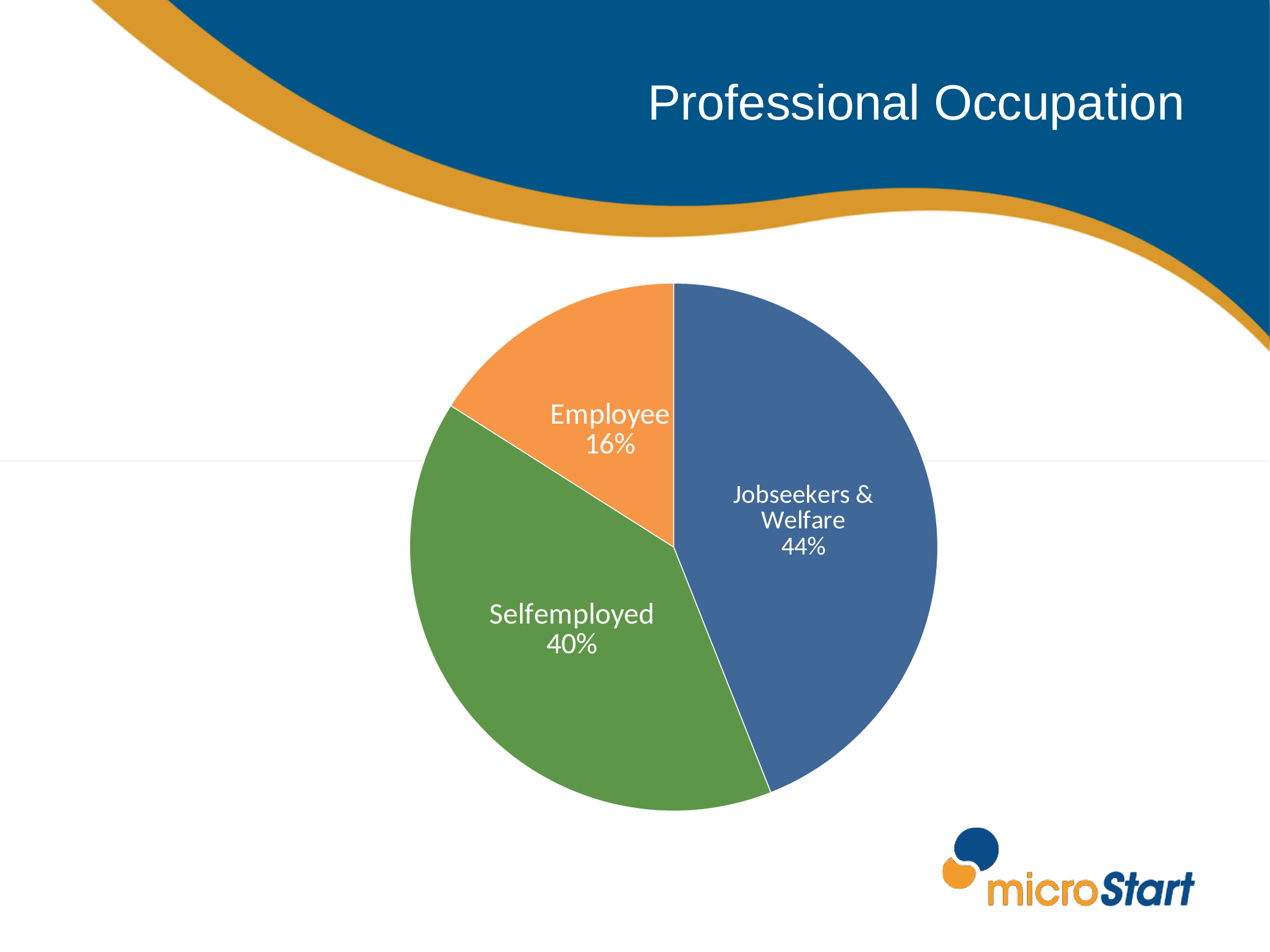
What share of the pie does Jobseekers & Welfare represent? 44% What is the title of the slide containing the chart? Professional Occupation What kind of chart is shown on the slide? Pie chart What colour is the Selfemployed slice? Green What share of the pie does Employee represent? 16% Which is larger, the Selfemployed slice or the Employee slice? Selfemployed What is the difference in percentage points between Jobseekers & Welfare and Employee? 28 What is the difference in percentage points between Selfemployed and Employee? 24 Which category has the largest slice of the pie? Jobseekers & Welfare What share of the pie does Selfemployed represent? 40% How many categories are shown in the pie chart? 3 Which category has the smallest slice of the pie? Employee